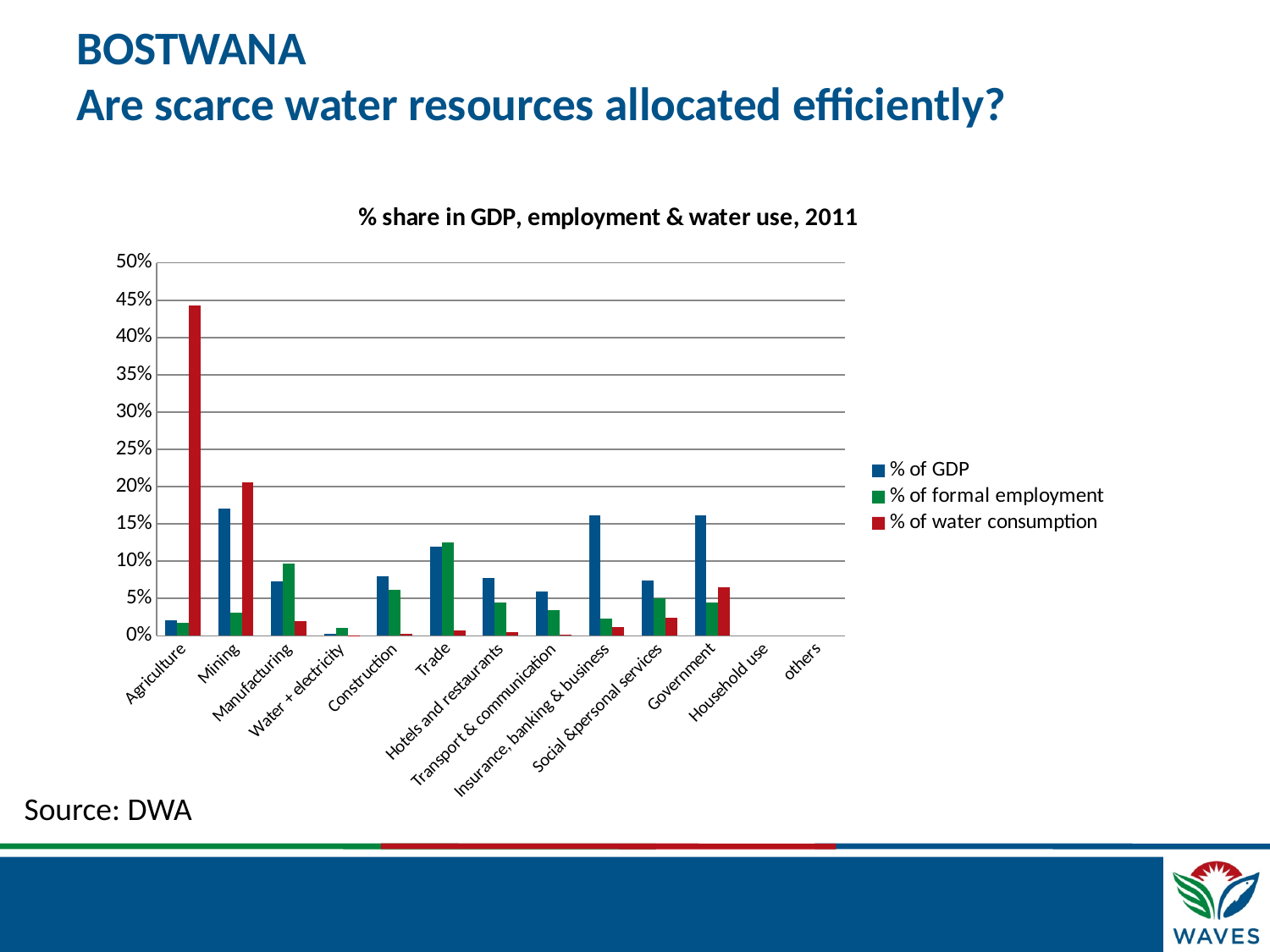
Which sector has the highest % of water consumption? Agriculture Which sector has the highest % of GDP? Mining What is the title of the chart? % share in GDP, employment & water use, 2011 What kind of chart is shown on the slide? bar chart Which is larger for Government: % of GDP or % of water consumption? % of GDP Is the % of water consumption for Agriculture greater or less than 40%? greater How many series does the legend list? 3 Which sector has the highest % of formal employment? Trade Which is larger for Mining: % of GDP or % of formal employment? % of GDP Is the % of GDP for Trade greater or less than 10%? greater How many sector categories are shown on the x axis? 13 Is the % of GDP for Mining greater or less than 15%? greater